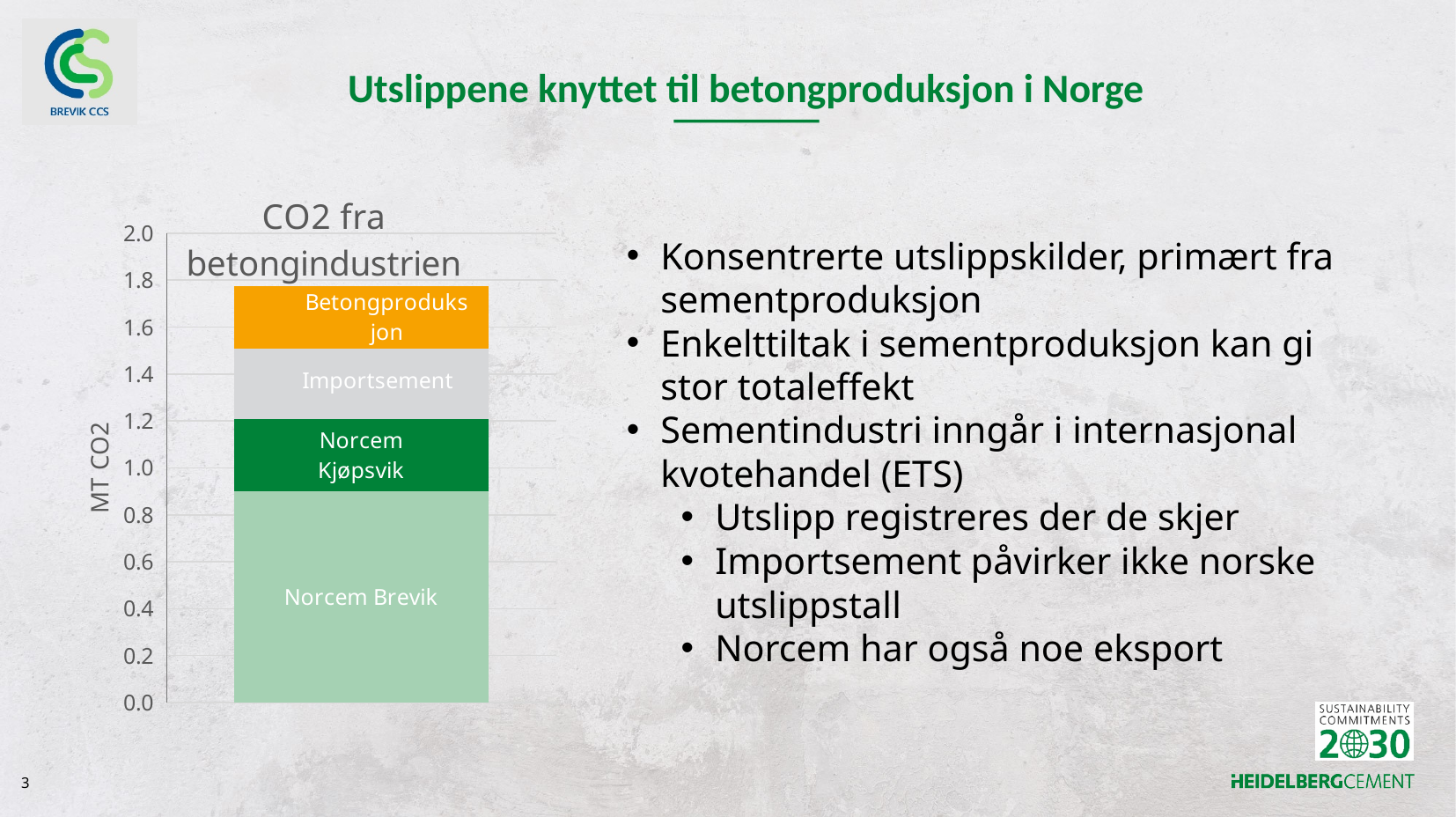
Is the value for Norcem Brevik greater or less than 0.8 MT CO2? greater What kind of chart is shown on the slide? Stacked bar chart How many segments make up the stacked bar in the chart? 4 Which segment is at the top of the stacked bar? Betongproduksjon What is the title of the chart? CO2 fra betongindustrien Which is larger, the Norcem Brevik segment or the Importsement segment? Norcem Brevik What is the label on the vertical axis of the chart? MT CO2 Which segment is at the bottom of the stacked bar? Norcem Brevik Which is larger, the Norcem Brevik segment or the Norcem Kjøpsvik segment? Norcem Brevik Is the value for Norcem Brevik greater or less than 1.0 MT CO2? less Is the total height of the stacked bar greater or less than 2.0 MT CO2? less Which segment of the stacked bar is the largest? Norcem Brevik